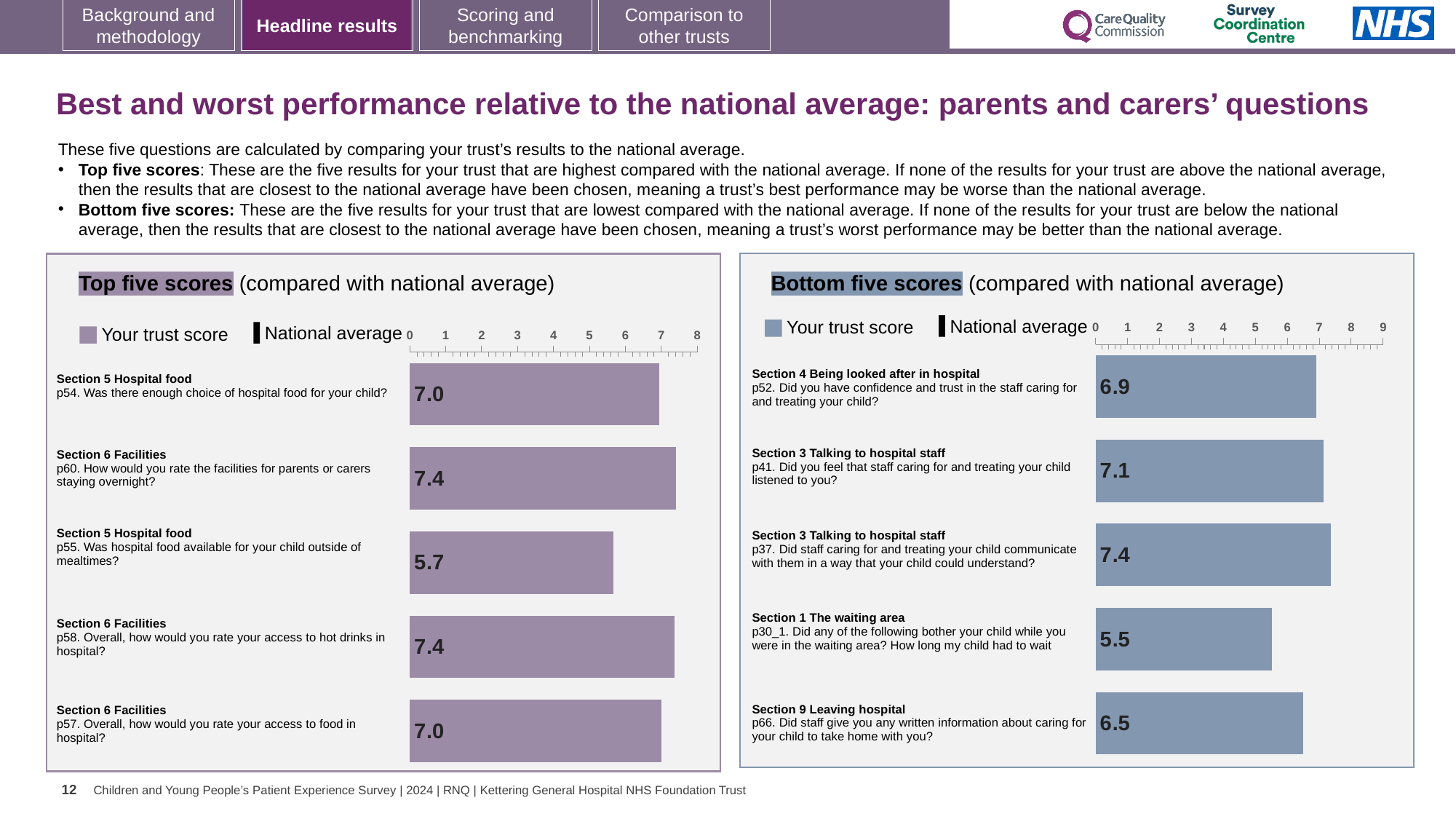
In the 'Bottom five scores' chart, which question has the highest trust score? p37. Did staff caring for and treating your child communicate with them in a way that your child could understand? How many questions are plotted in the 'Top five scores' chart? 5 In the 'Bottom five scores' chart, what is the trust score for p66, 'Did staff give you any written information about caring for your child to take home with you?' 6.5 In the 'Top five scores' chart, what is the trust score for p54, 'Was there enough choice of hospital food for your child?' 7.0 In the 'Bottom five scores' chart, which has the larger trust score: p52 or p37? p37 What type of chart is the 'Bottom five scores' chart? Bar chart In the 'Top five scores' chart, which question has the lowest trust score? p55. Was hospital food available for your child outside of mealtimes? In the 'Bottom five scores' chart, what is the difference between the trust scores for p41 and p66? 0.6 In the 'Bottom five scores' chart, what is the trust score for p30_1, 'How long my child had to wait'? 5.5 In the 'Top five scores' chart, what is the difference between the trust scores for p60 and p55? 1.7 In the 'Top five scores' chart, what is the trust score for p55, 'Was hospital food available for your child outside of mealtimes?' 5.7 In the 'Bottom five scores' chart, which question has the lowest trust score? p30_1. How long my child had to wait